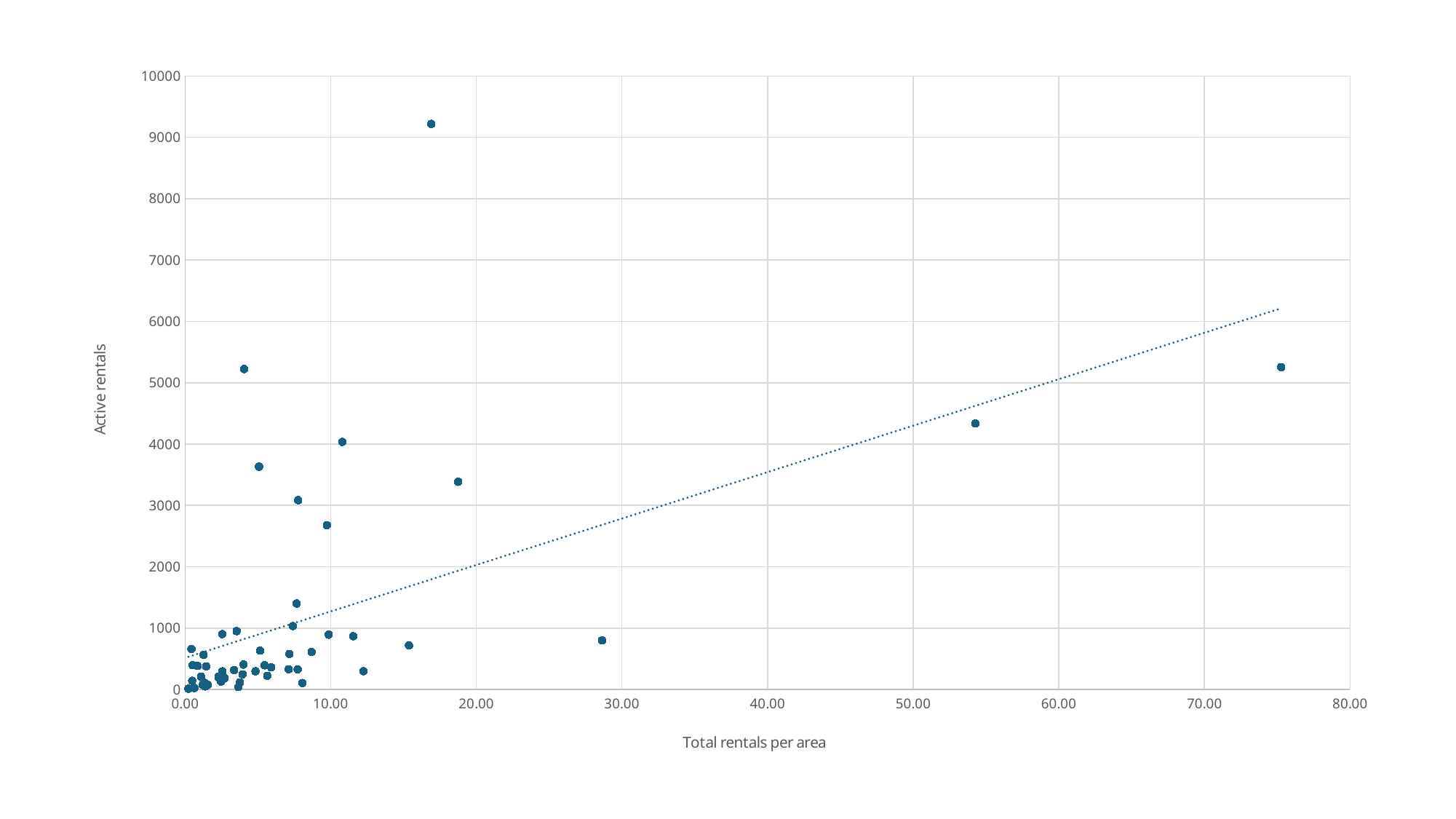
Is the Active rentals value of the point near 54 on the x axis greater or less than 4000? greater What is the title of the y axis? Active rentals What is the title of the x axis? Total rentals per area Is the Active rentals value of the point near 28.6 on the x axis greater or less than 1000? less Does the dotted trendline rise or fall as Total rentals per area increases? rise Is the Active rentals value of the point near 4 on the x axis that lies above the trendline greater or less than 5000? greater Which has the larger Active rentals value: the point near 54 on the x axis or the point near 75 on the x axis? the point near 75 What kind of chart is shown on the slide? scatter chart